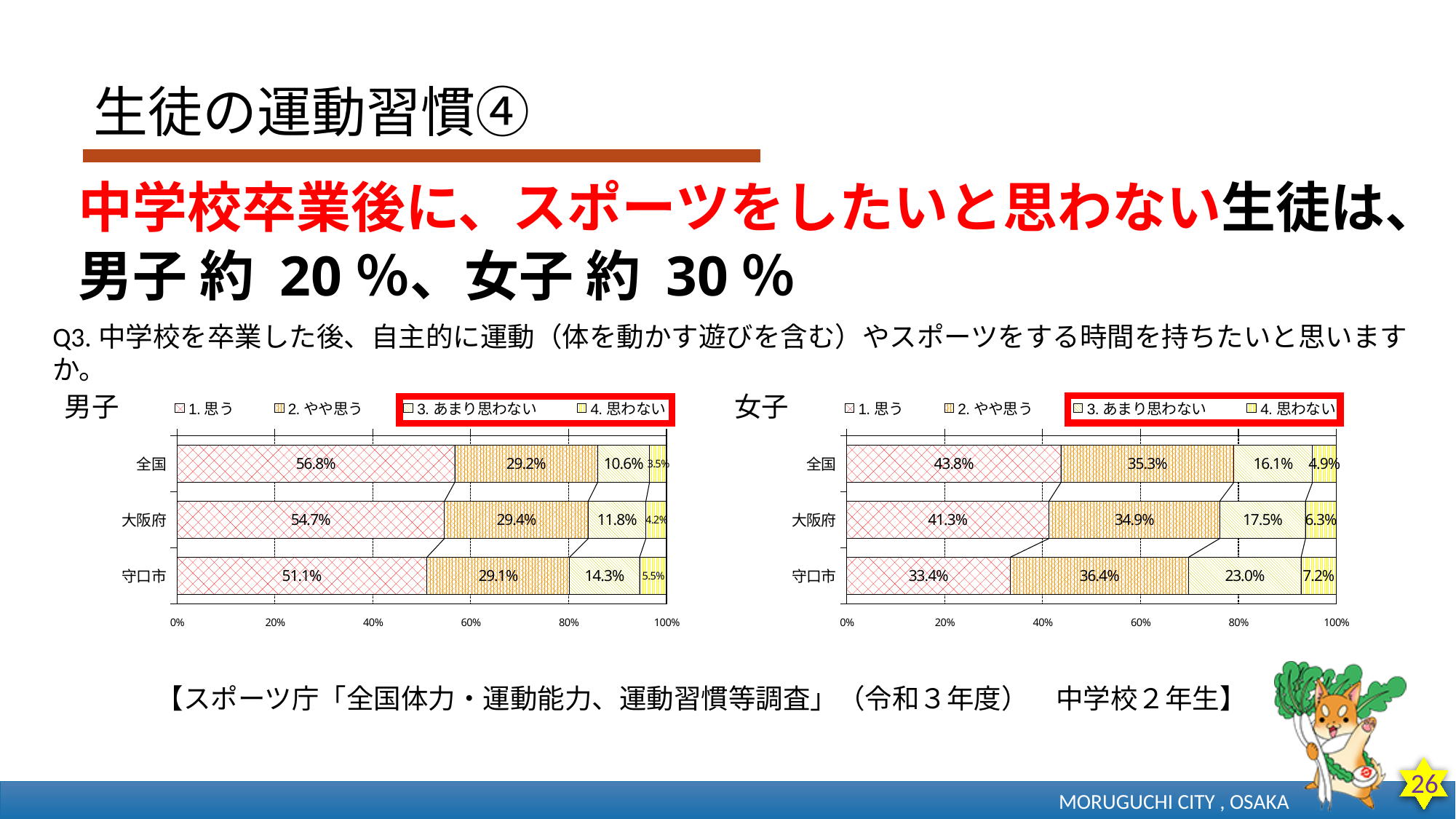
In the 男子 chart, what is the value of 1. 思う for 守口市? 51.1% How many categories are shown in the 女子 chart? 3 In the 男子 chart, which category has the highest value for 1. 思う? 全国 How many series does the legend of the 男子 chart list? 4 In the 女子 chart, what is the value of 4. 思わない for 大阪府? 6.3% In the 男子 chart, is the 1. 思う value for 大阪府 greater or less than 40%? greater In the 女子 chart, which is larger: the 2. やや思う value for 守口市 or for 全国? 守口市 In the 女子 chart, which category has the lowest value for 1. 思う? 守口市 In the 女子 chart, what is the combined value of 3. あまり思わない and 4. 思わない for 守口市? 30.2% In the 女子 chart, what is the value of 3. あまり思わない for 守口市? 23.0% What type of chart is the 女子 chart? Stacked bar chart In the 男子 chart, what is the difference between the 1. 思う values for 全国 and 守口市? 5.7%